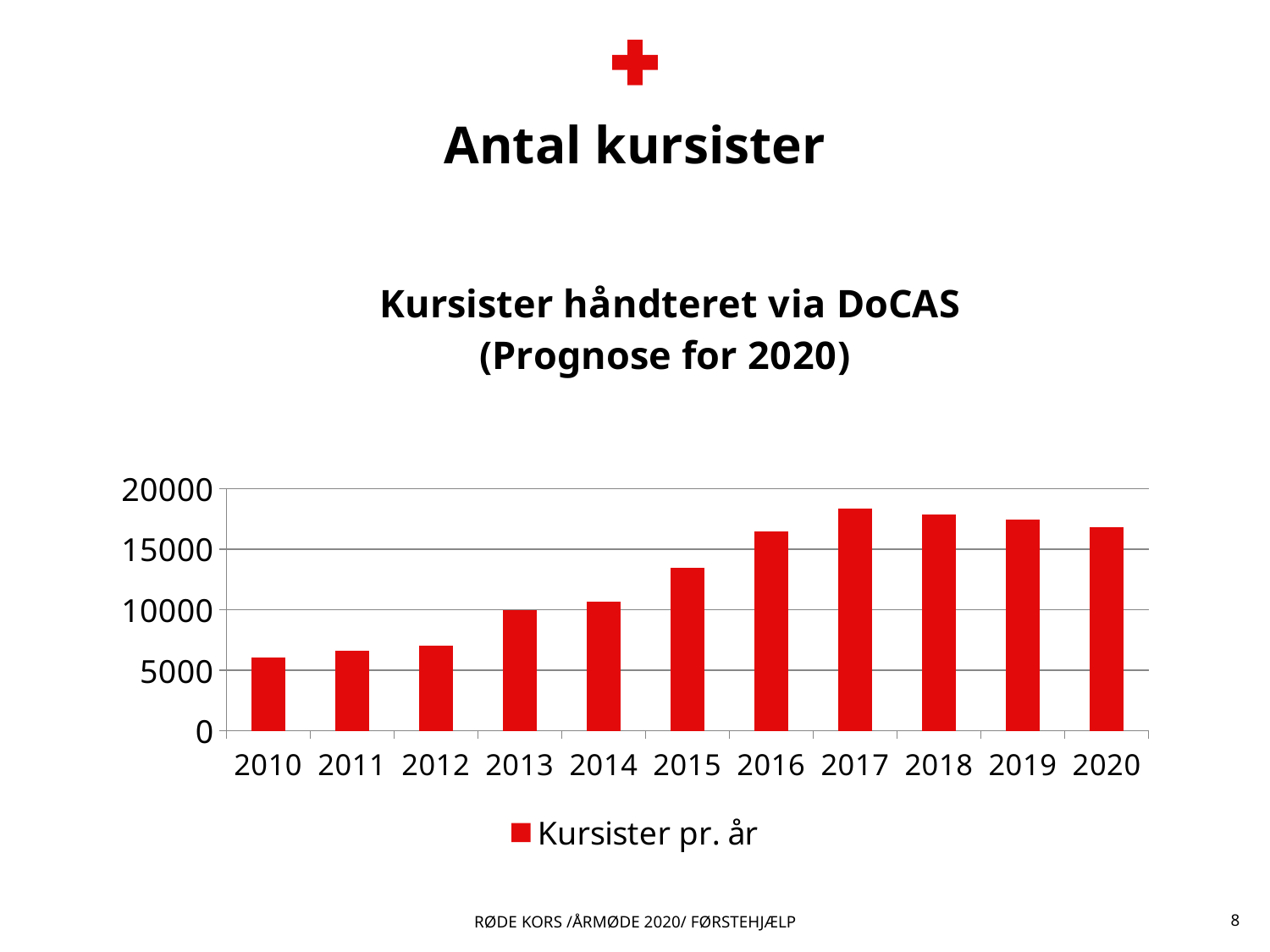
What kind of chart is shown on the slide? bar chart Which year has the larger value, 2015 or 2016? 2016 Is the value for 2010 greater or less than 10000? less Which year has the lowest number of kursister? 2010 How many series does the legend list? 1 Is the value for 2015 greater or less than 10000? greater Do the values rise or fall from 2010 to 2017? rise What is the name of the series shown in the legend? Kursister pr. år Which year has the highest number of kursister? 2017 Is the value for 2017 greater or less than 15000? greater What is the title of the chart? Kursister håndteret via DoCAS (Prognose for 2020) How many years are shown on the x axis? 11